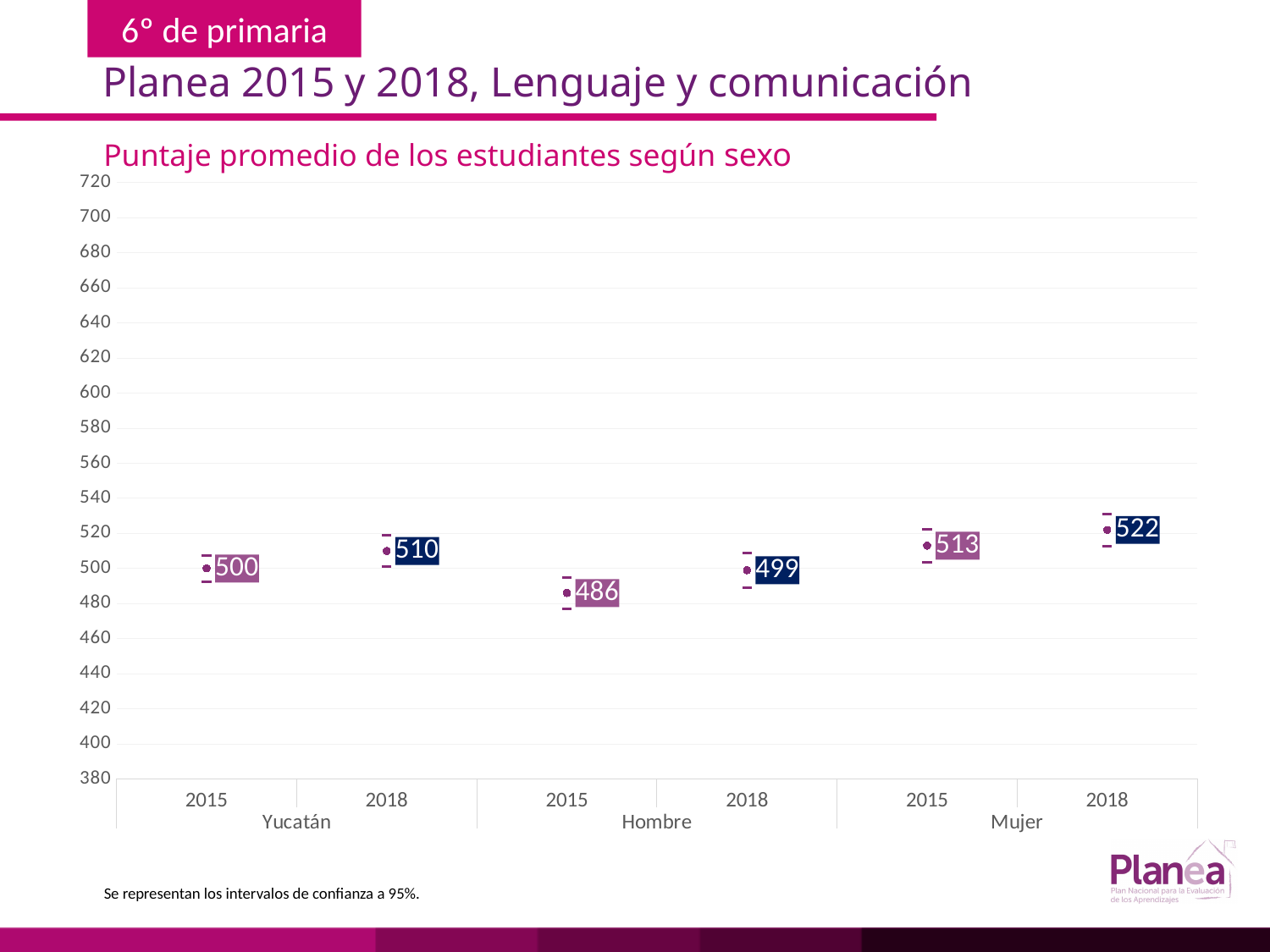
Which is larger, the Mujer score in 2015 or the Yucatán score in 2018? Mujer 2015 What is the title of the chart? Puntaje promedio de los estudiantes según sexo What is the average score for Yucatán in 2015? 500 What is the average score for Mujer in 2018? 522 Which group and year has the lowest average score? Hombre 2015 By how much did the Yucatán average score change from 2015 to 2018? 10 How many data points are plotted on the chart? 6 What is the difference between the Mujer score in 2018 and the Hombre score in 2018? 23 What is the average score for Hombre in 2018? 499 Did the Hombre average score rise or fall from 2015 to 2018? rise Is the value for Hombre in 2015 greater or less than 500? less Which group and year has the highest average score? Mujer 2018